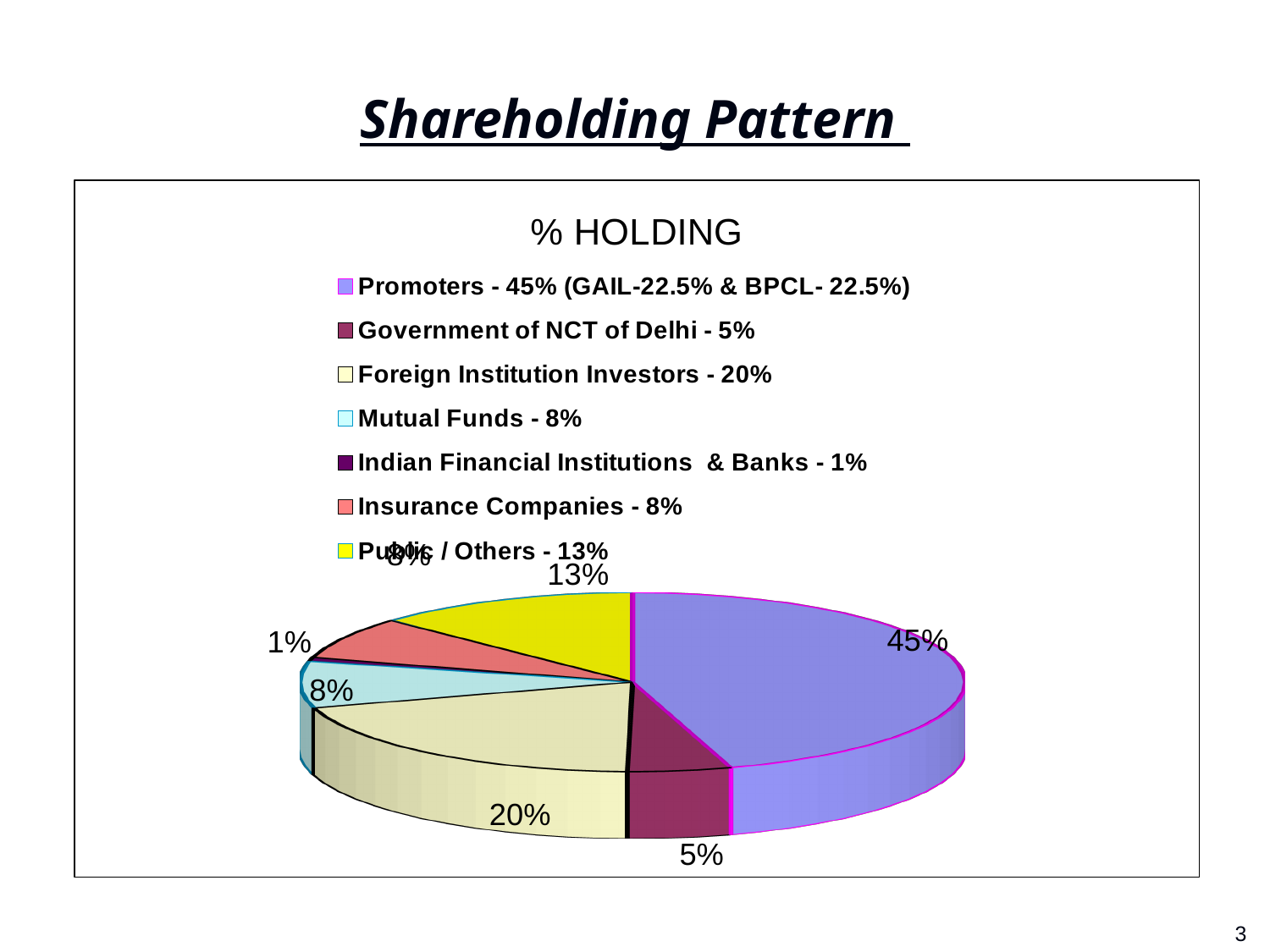
What kind of chart is shown on the slide? pie chart What percentage of holding do Promoters have? 45% What is the holding of Public / Others? 13% What is the holding of Foreign Institution Investors? 20% What is the combined holding of Mutual Funds and Insurance Companies? 16% What is the difference between the Promoters' holding and the Foreign Institution Investors' holding? 25% Which category has the largest share of holding? Promoters What is the chart's title? % HOLDING Which is larger, the holding of Public / Others or the holding of Mutual Funds? Public / Others What is the holding of the Government of NCT of Delhi? 5% Which category has the smallest share of holding? Indian Financial Institutions & Banks How many categories does the legend list? 7